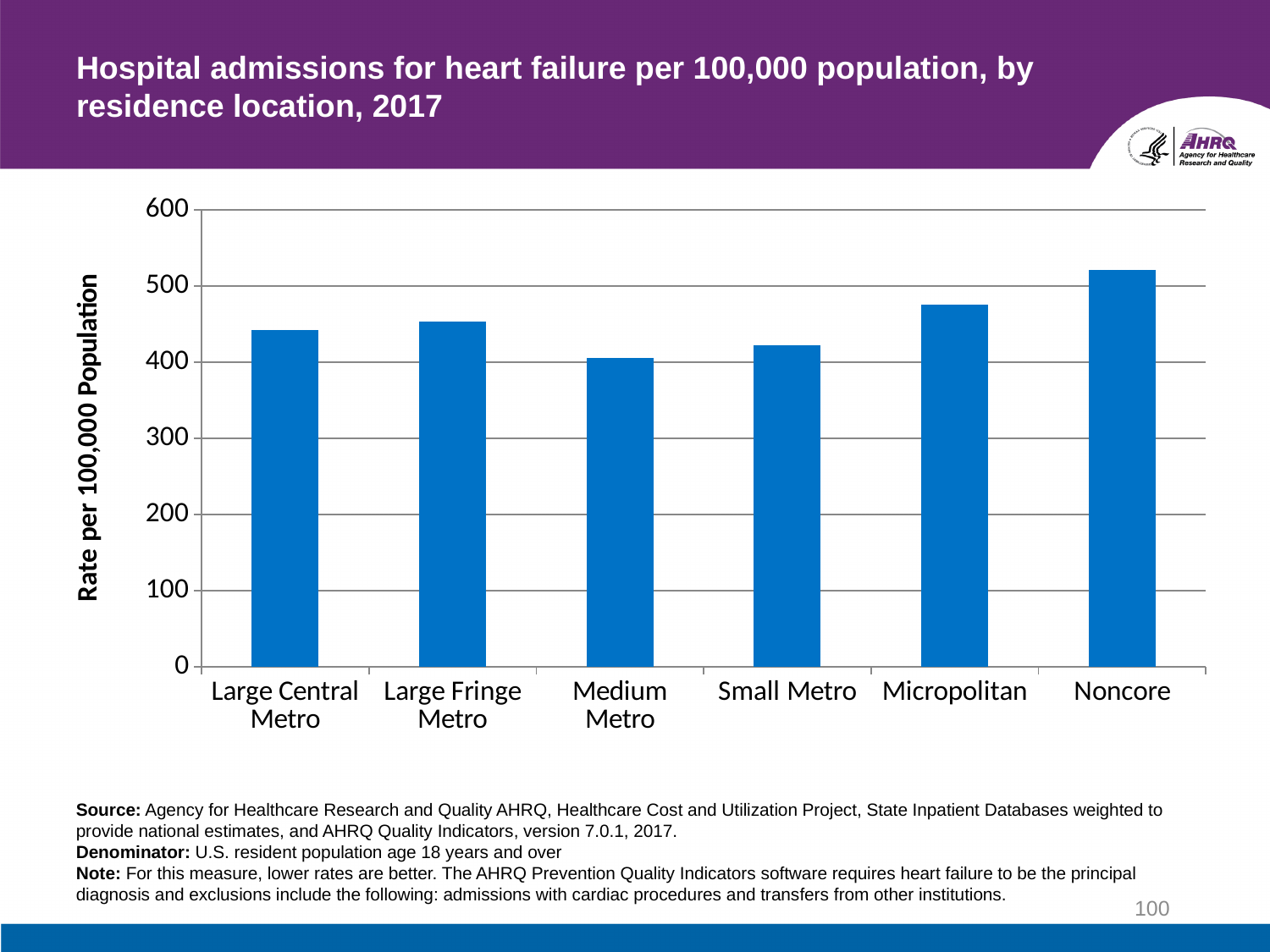
What kind of chart is shown on the slide? Bar chart How many residence location categories are shown on the x axis? 6 Which is larger, the value for Micropolitan or the value for Small Metro? Micropolitan Which residence location has the lowest rate of hospital admissions for heart failure? Medium Metro Which is larger, the value for Large Fringe Metro or the value for Medium Metro? Large Fringe Metro Is the value for Small Metro greater or less than 500? less Is the value for Large Central Metro greater or less than 400? greater Is the value for Micropolitan greater or less than 500? less What is the label on the vertical axis of the chart? Rate per 100,000 Population Which is larger, the value for Noncore or the value for Large Central Metro? Noncore Which residence location has the highest rate of hospital admissions for heart failure? Noncore